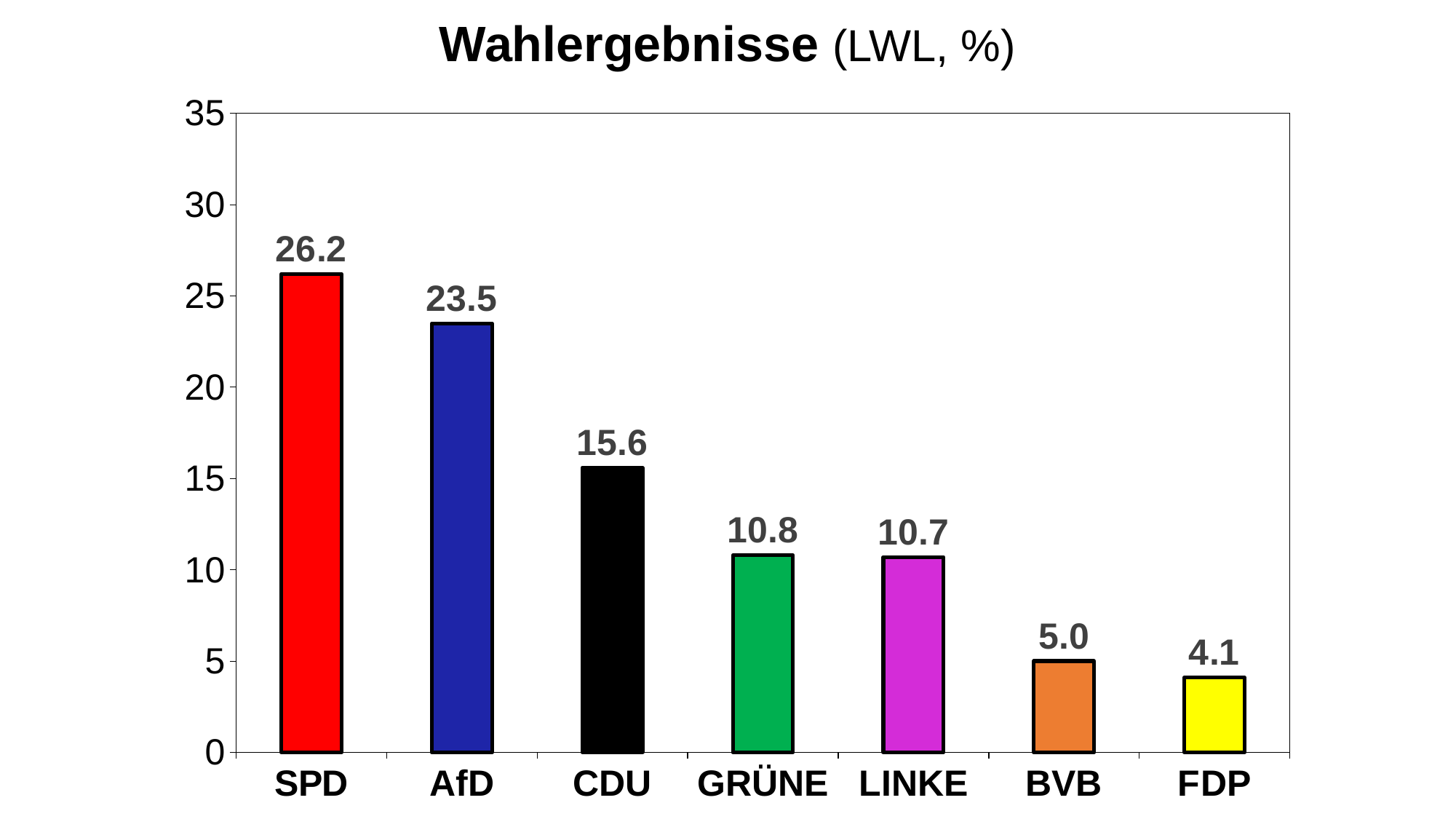
What is the difference between the values for SPD and AfD? 2.7 What is the title of the chart? Wahlergebnisse (LWL, %) What kind of chart is shown on the slide? bar chart Which party has the highest value? SPD Is the value for GRÜNE greater or less than 15? less What is the value for BVB? 5.0 Which is larger, the value for AfD or the value for CDU? AfD How many parties are shown on the chart? 7 Which party has the lowest value? FDP What is the value for SPD? 26.2 What is the value for CDU? 15.6 What is the difference between the values for CDU and FDP? 11.5